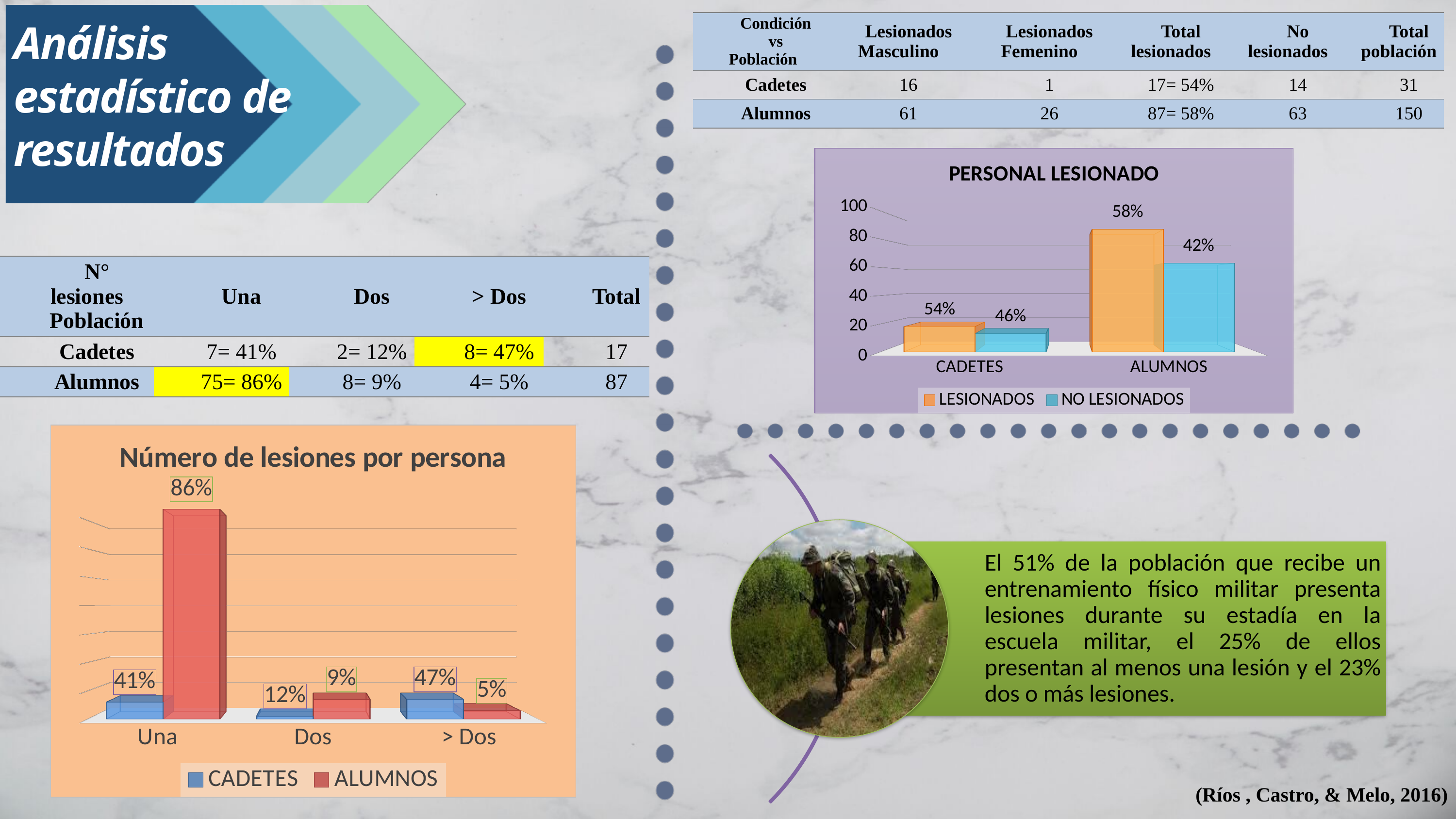
In the 'PERSONAL LESIONADO' chart, what is the value for NO LESIONADOS in the CADETES category? 46% In the 'PERSONAL LESIONADO' chart, what is the value for LESIONADOS in the ALUMNOS category? 58% In the 'PERSONAL LESIONADO' chart, what is the difference between LESIONADOS and NO LESIONADOS for ALUMNOS? 16% In the 'Número de lesiones por persona' chart, what is the difference between the CADETES and ALUMNOS values in the 'Una' category? 45% In the 'PERSONAL LESIONADO' chart, what colour represents the LESIONADOS series? Orange In the 'Número de lesiones por persona' chart, what is the value for CADETES in the '> Dos' category? 47% What kind of chart is the 'PERSONAL LESIONADO' chart? Bar chart In the 'Número de lesiones por persona' chart, which category has the lowest value for ALUMNOS? > Dos How many categories are shown on the x axis of the 'Número de lesiones por persona' chart? 3 How many series does the legend of the 'Número de lesiones por persona' chart list? 2 In the 'Número de lesiones por persona' chart, what is the value for ALUMNOS in the 'Una' category? 86%